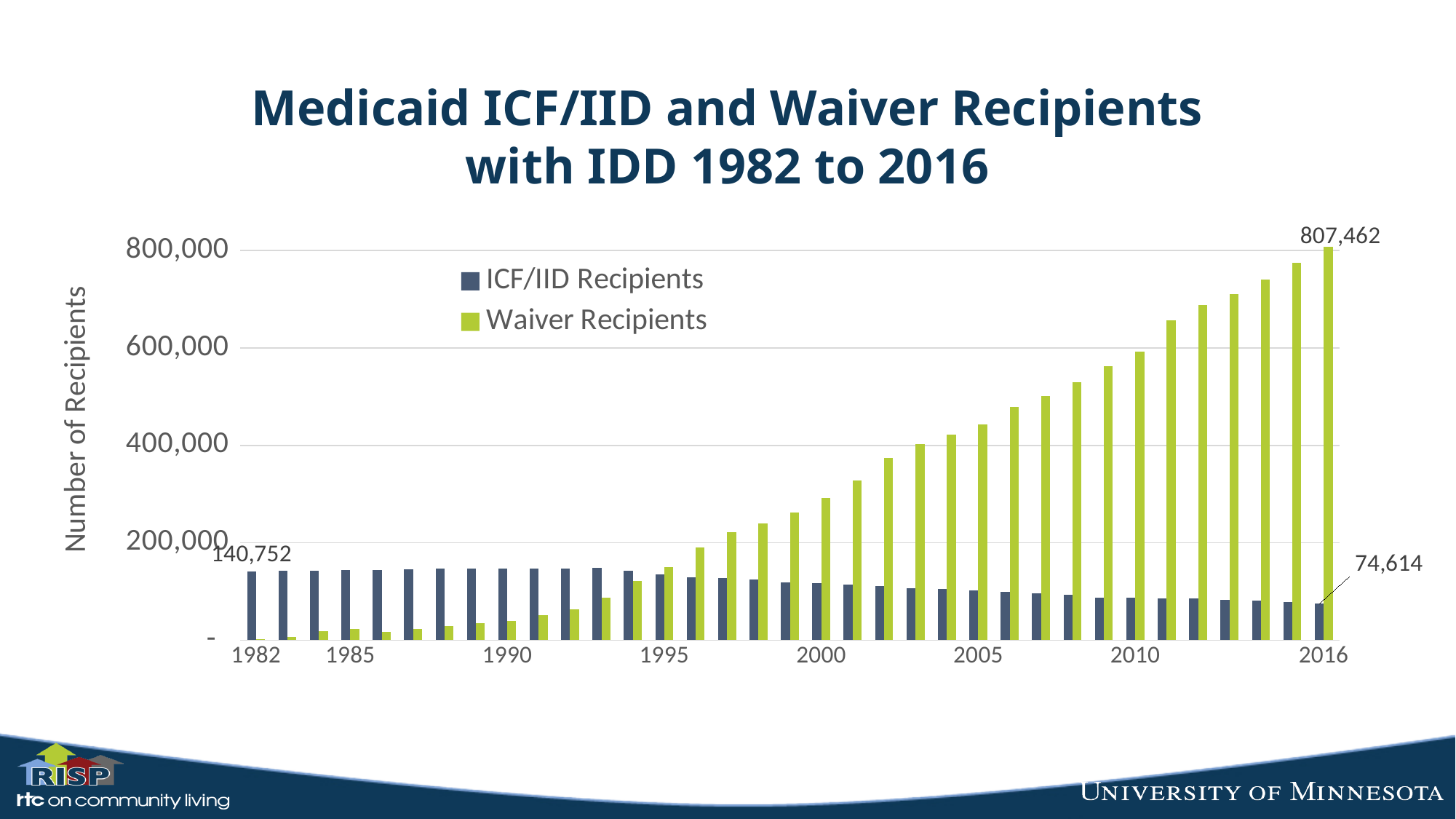
In which year is the number of Waiver Recipients highest? 2016 What is the value for Waiver Recipients in 2016? 807,462 What kind of chart is shown on the slide? Bar chart In 2016, which series is larger, Waiver Recipients or ICF/IID Recipients? Waiver Recipients What is the value for ICF/IID Recipients in 2016? 74,614 In 2016, what is the difference between Waiver Recipients and ICF/IID Recipients? 732,848 How many series does the legend list? 2 Do the values for Waiver Recipients rise or fall from 1982 to 2016? Rise What is the value for ICF/IID Recipients in 1982? 140,752 Is the value for Waiver Recipients in 2005 greater or less than 400,000? greater By how much did the number of ICF/IID Recipients fall between 1982 and 2016? 66,138